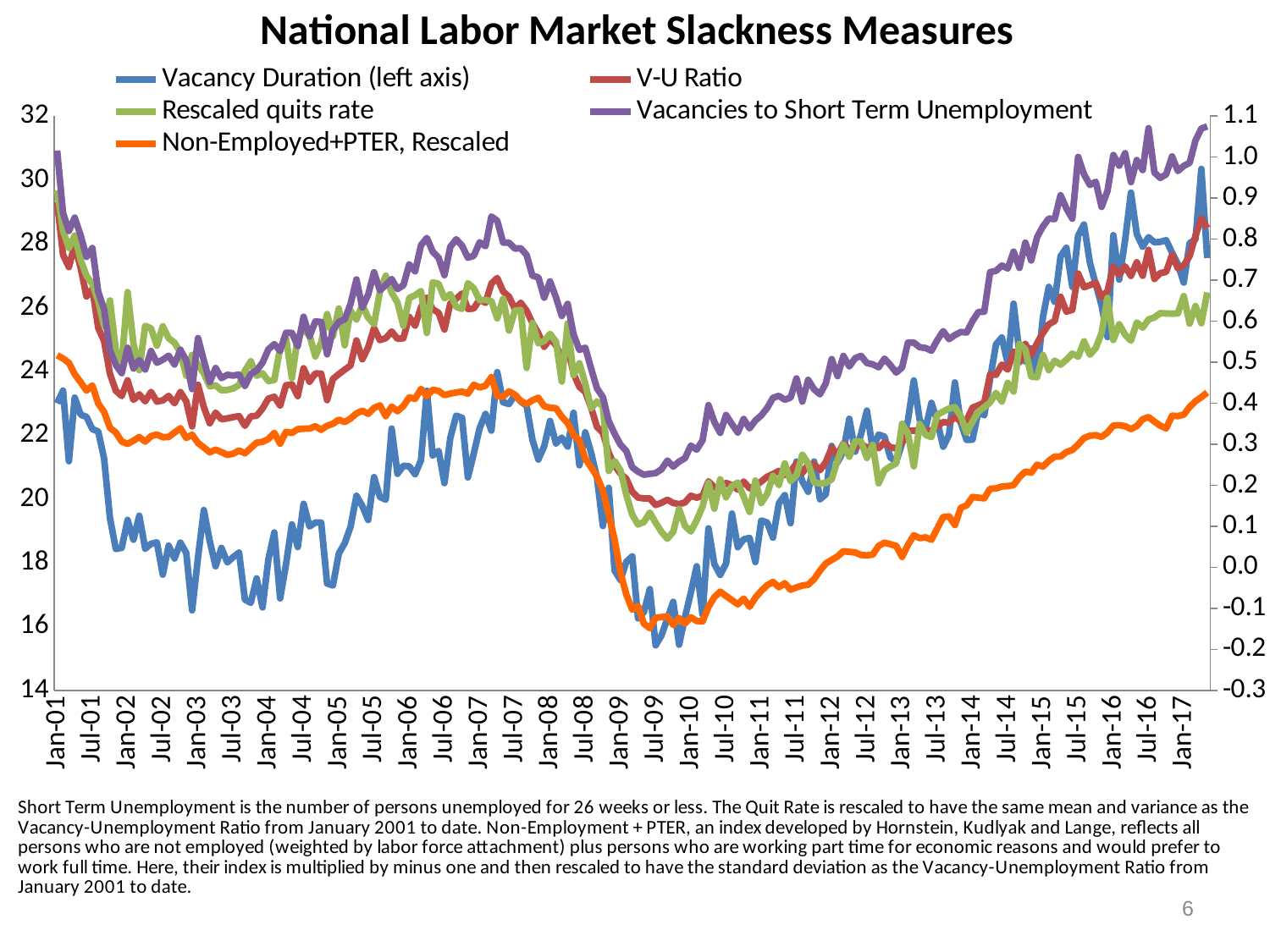
What kind of chart is shown on the slide? line chart Is the value for Vacancies to Short Term Unemployment at Jan-17 greater or less than 0.9? greater Does the Non-Employed+PTER, Rescaled series rise or fall from Jan-10 to Jan-17? rise How many series does the legend list? 5 Is the value for V-U Ratio at Jul-09 greater or less than 0.3? less What is the title of the chart? National Labor Market Slackness Measures Which series is plotted against the left axis? Vacancy Duration Is the value for Vacancy Duration at Jan-01 greater or less than 20? greater At Jan-17, which is higher: Vacancies to Short Term Unemployment or V-U Ratio? Vacancies to Short Term Unemployment Does the Vacancy Duration series rise or fall from Jan-01 to Jan-03? fall